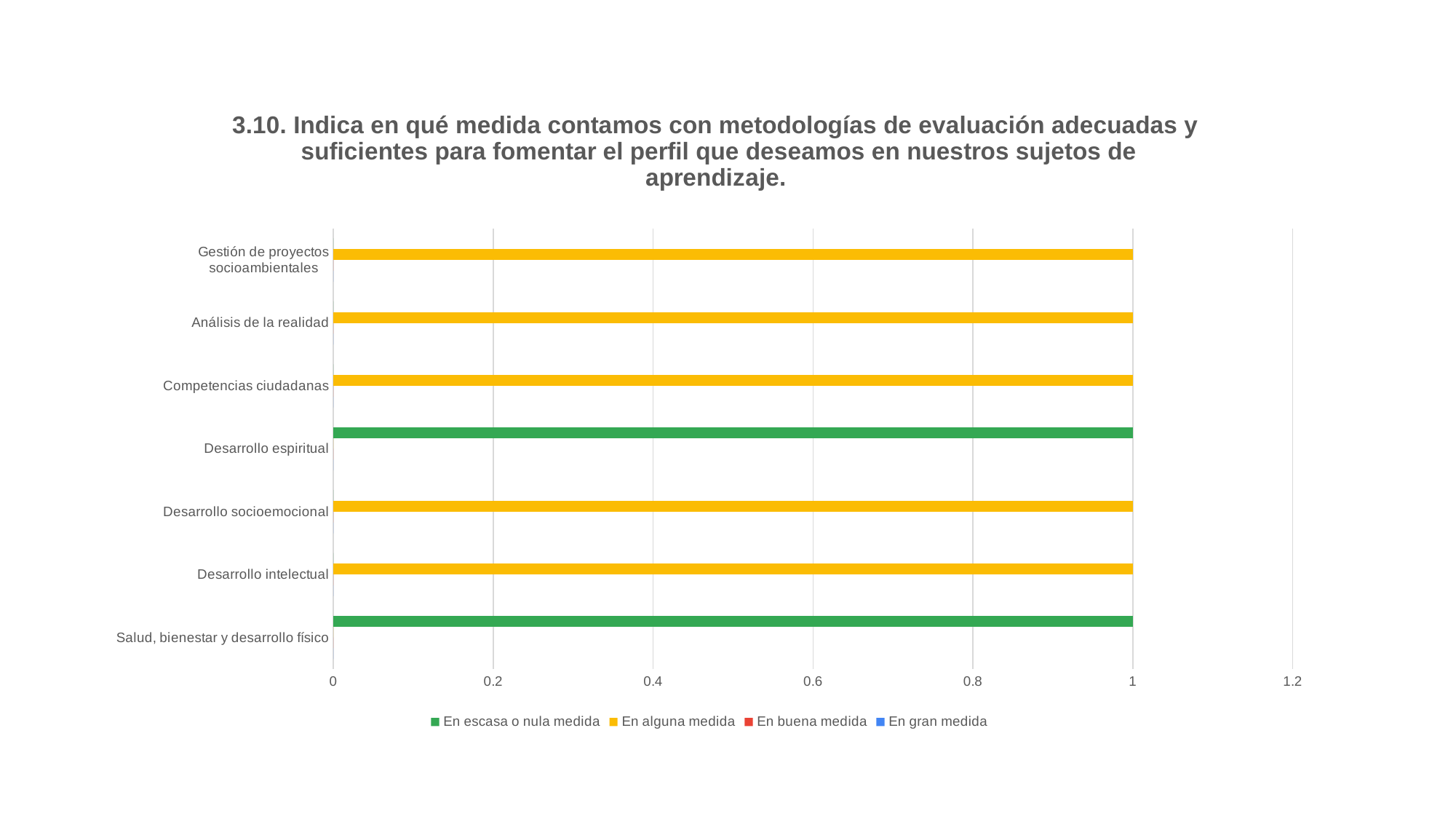
Is the value for Desarrollo intelectual greater or less than 0.8? greater Is the value for Desarrollo socioemocional greater or less than 1.2? less What is the value of the 'En escasa o nula medida' bar for Salud, bienestar y desarrollo físico? 1 Which series does the bar for Competencias ciudadanas belong to? En alguna medida What is the value of the 'En escasa o nula medida' bar for Desarrollo espiritual? 1 How many series does the chart legend list? 4 What is the value of the 'En alguna medida' bar for Análisis de la realidad? 1 Which series does the bar for Desarrollo espiritual belong to? En escasa o nula medida How many categories are listed on the vertical axis of the chart? 7 What is the value of the 'En alguna medida' bar for Gestión de proyectos socioambientales? 1 What is the difference between the value for Desarrollo intelectual and the value for Desarrollo socioemocional? 0 What kind of chart is shown on the slide? bar chart